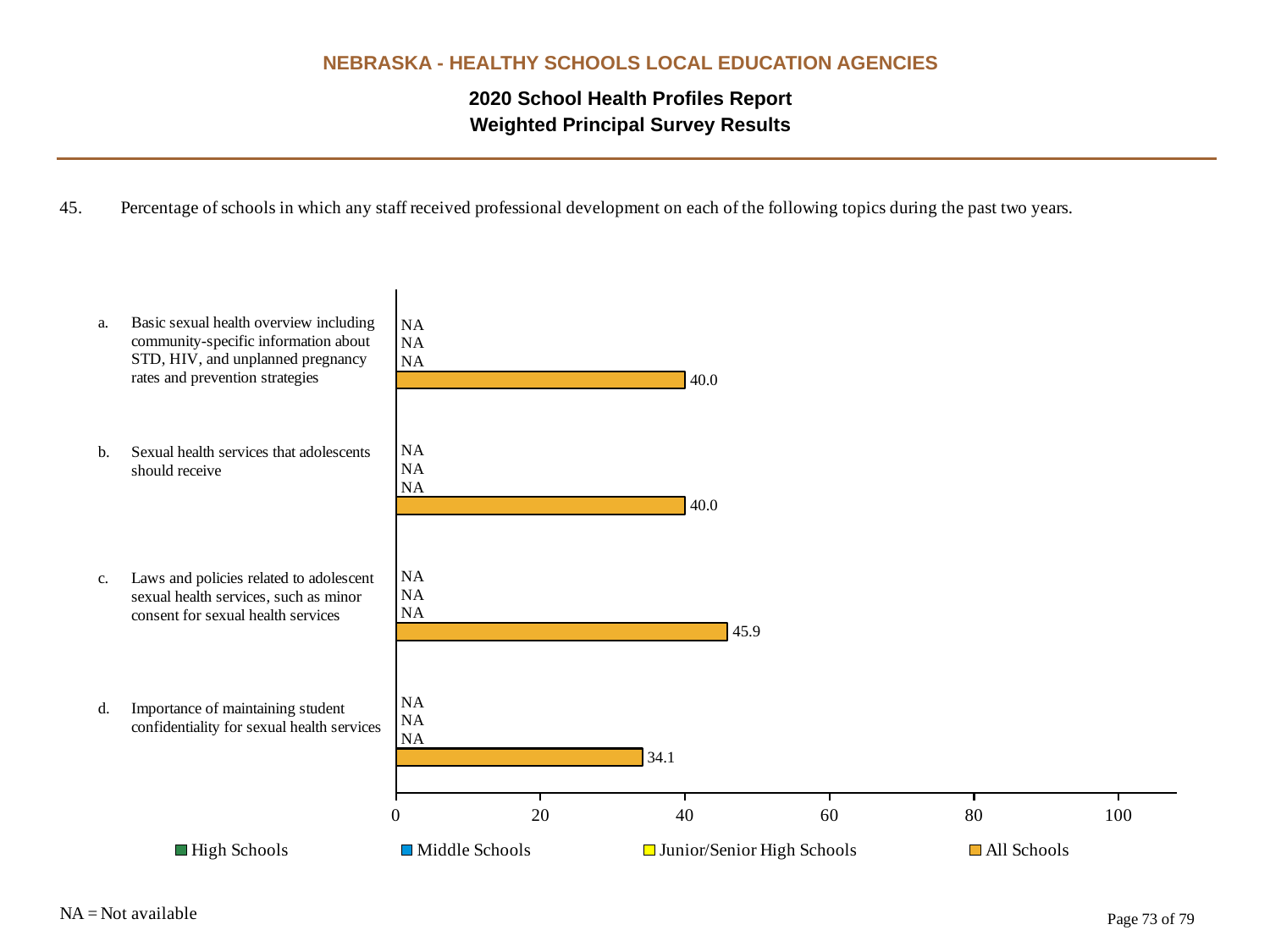
How many topics (categories) are plotted on the chart? 4 What kind of chart is shown on the slide? bar chart What is the All Schools value for topic a, basic sexual health overview? 40.0 How many series does the legend list? 4 What is the All Schools value for topic d, importance of maintaining student confidentiality for sexual health services? 34.1 Which topic has the lowest All Schools value? d. Importance of maintaining student confidentiality for sexual health services What is the All Schools value for topic c, laws and policies related to adolescent sexual health services? 45.9 Is the All Schools value for topic c larger or smaller than the All Schools value for topic a? larger What is the difference between the All Schools values for topic c and topic d? 11.8 What is the High Schools value shown for topic b, sexual health services that adolescents should receive? NA Is the All Schools value for topic d greater or less than 40? less Which topic has the highest All Schools value? c. Laws and policies related to adolescent sexual health services